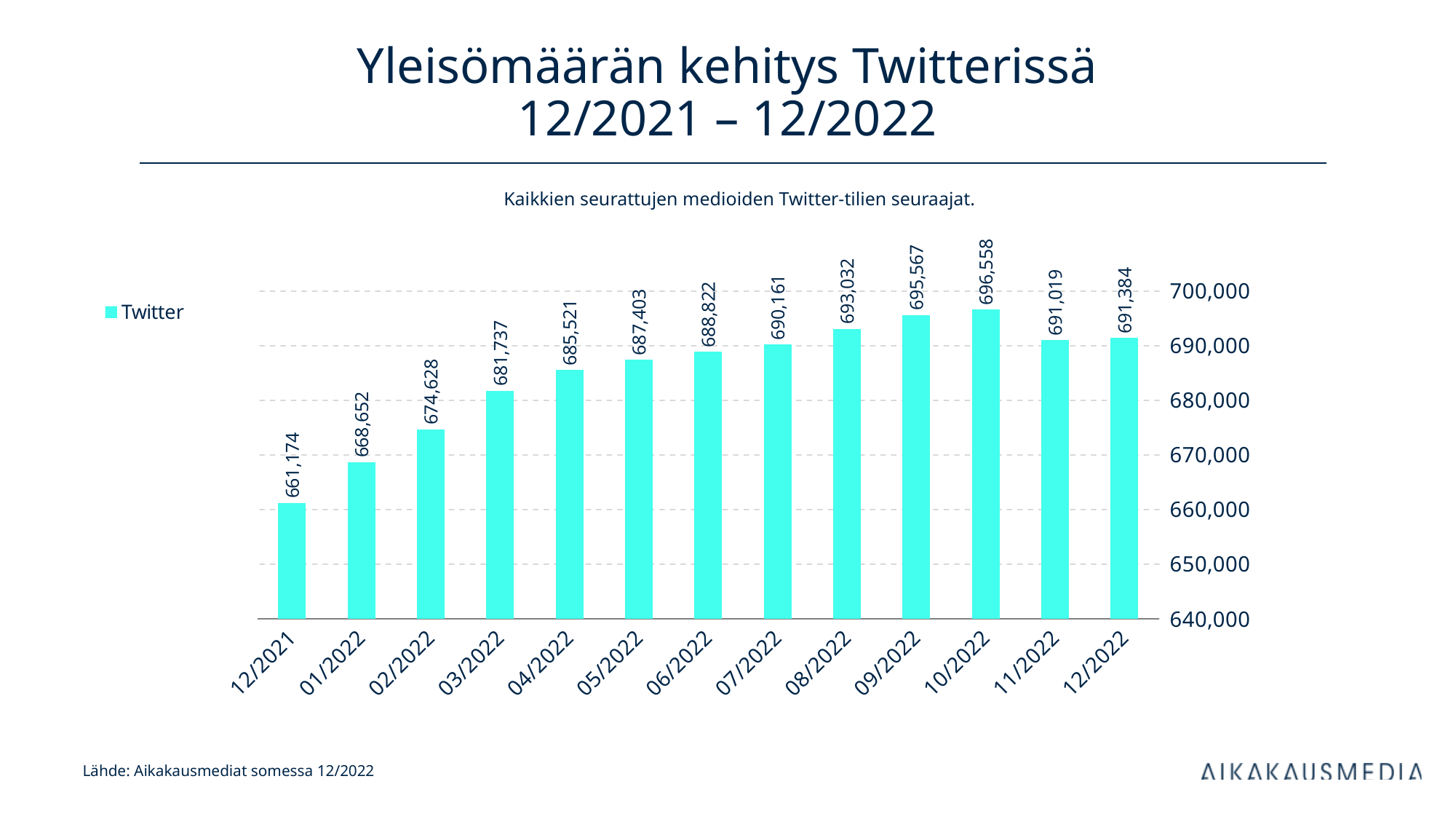
Which month has the highest value? 10/2022 What is the value for 06/2022? 688,822 What is the difference between the values for 10/2022 and 09/2022? 991 Which month has the lowest value? 12/2021 How many months are shown on the x axis? 13 What kind of chart is this? bar chart What series name does the legend show? Twitter What is the value for 10/2022? 696,558 Is the value for 02/2022 greater or less than 680,000? less Which is larger, the value for 03/2022 or the value for 08/2022? 08/2022 What is the value for 12/2021? 661,174 What is the difference between the values for 12/2022 and 12/2021? 30,210